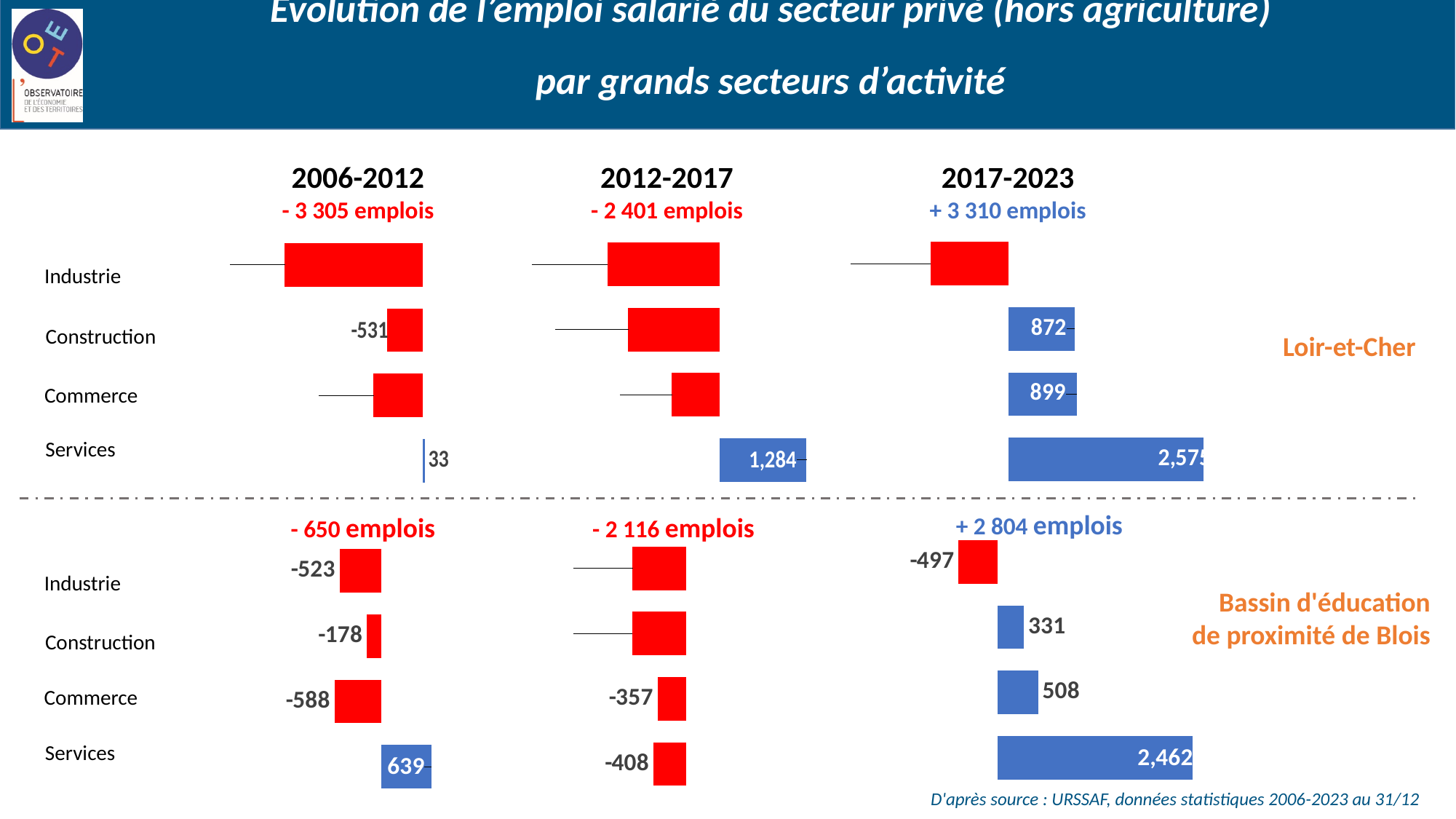
What kind of chart is used on the slide? Bar chart In the Bassin d'éducation de proximité de Blois 2006-2012 chart, which sector has the highest value? Services In the Loir-et-Cher 2012-2017 chart, what is the value for Services? 1,284 In the Loir-et-Cher 2017-2023 chart, what is the difference between the Commerce value and the Construction value? 27 In the Bassin d'éducation de proximité de Blois 2017-2023 chart, which sector has the lowest value? Industrie In the Loir-et-Cher 2017-2023 chart, what is the value for Commerce? 899 How many sectors are shown in each chart on the slide? 4 In the Bassin d'éducation de proximité de Blois 2006-2012 chart, what is the value for Commerce? -588 In the Loir-et-Cher 2006-2012 chart, what is the value for Construction? -531 What total change in jobs is shown for Loir-et-Cher over 2017-2023? + 3 310 emplois In the Bassin d'éducation de proximité de Blois 2017-2023 chart, what is the value for Services? 2,462 In the Bassin d'éducation de proximité de Blois 2017-2023 chart, is the value for Commerce or Construction larger? Commerce